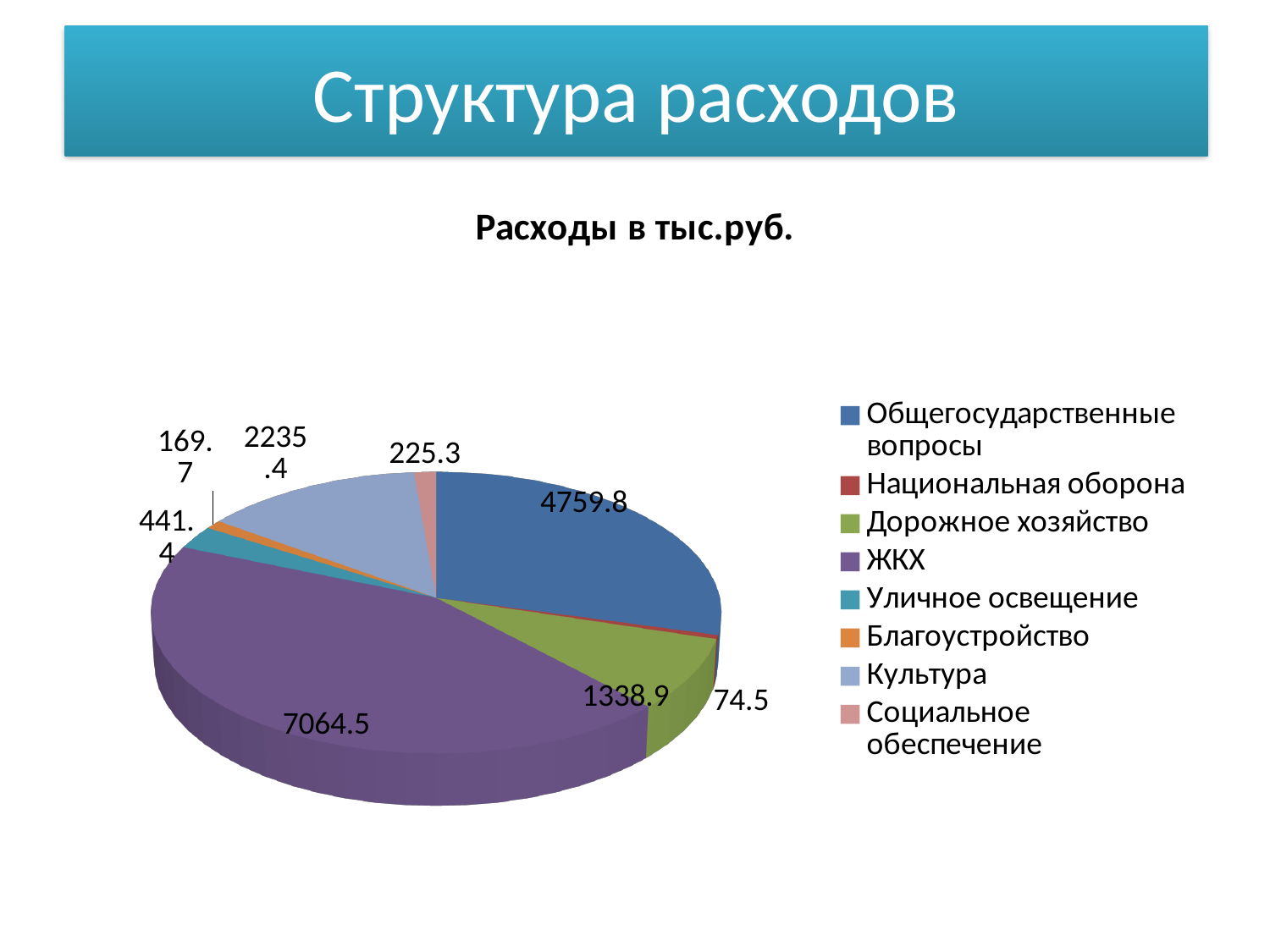
What is the value for Общегосударственные вопросы? 4759.8 What is the value for Культура? 2235.4 What is the difference between the values for ЖКХ and Общегосударственные вопросы? 2304.7 Which category has the smallest value? Национальная оборона What type of chart is shown on the slide? Pie chart What is the value for ЖКХ? 7064.5 What is the title of the chart? Расходы в тыс.руб. What is the value for Национальная оборона? 74.5 How many categories does the pie chart have? 8 Which is larger, the value for Дорожное хозяйство or the value for Культура? Культура Which category has the largest value? ЖКХ What colour is the slice for Уличное освещение? Teal